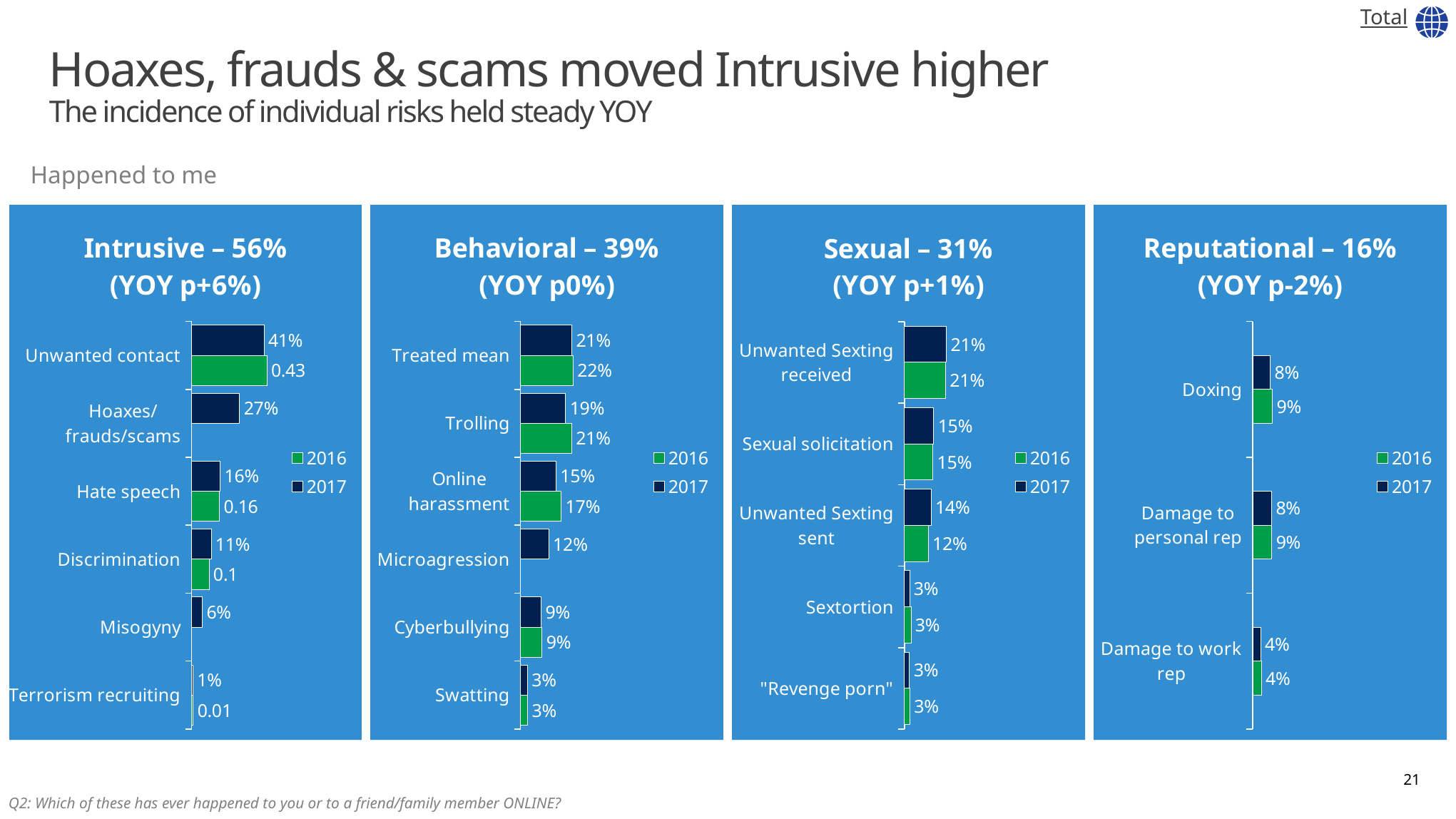
In the Reputational chart, what is the 2016 value for Doxing? 9% In the Behavioral chart, what is the difference between the 2017 values for Treated mean and Trolling? 2 percentage points In the Intrusive chart, which category has the lowest 2017 value? Terrorism recruiting In the Sexual chart, how many categories are shown? 5 In the Sexual chart, which year has the larger value for Unwanted Sexting sent, 2016 or 2017? 2017 How many series does the legend of the Intrusive chart list? 2 In the Behavioral chart, what is the 2016 value for Trolling? 21% What type of chart is the Behavioral chart? Bar chart In the Behavioral chart, which category has the highest 2017 value? Treated mean In the Sexual chart, what is the 2017 value for Unwanted Sexting sent? 14% In the Reputational chart, how many categories are shown? 3 In the Intrusive chart, what is the 2017 value for Hoaxes/frauds/scams? 27%